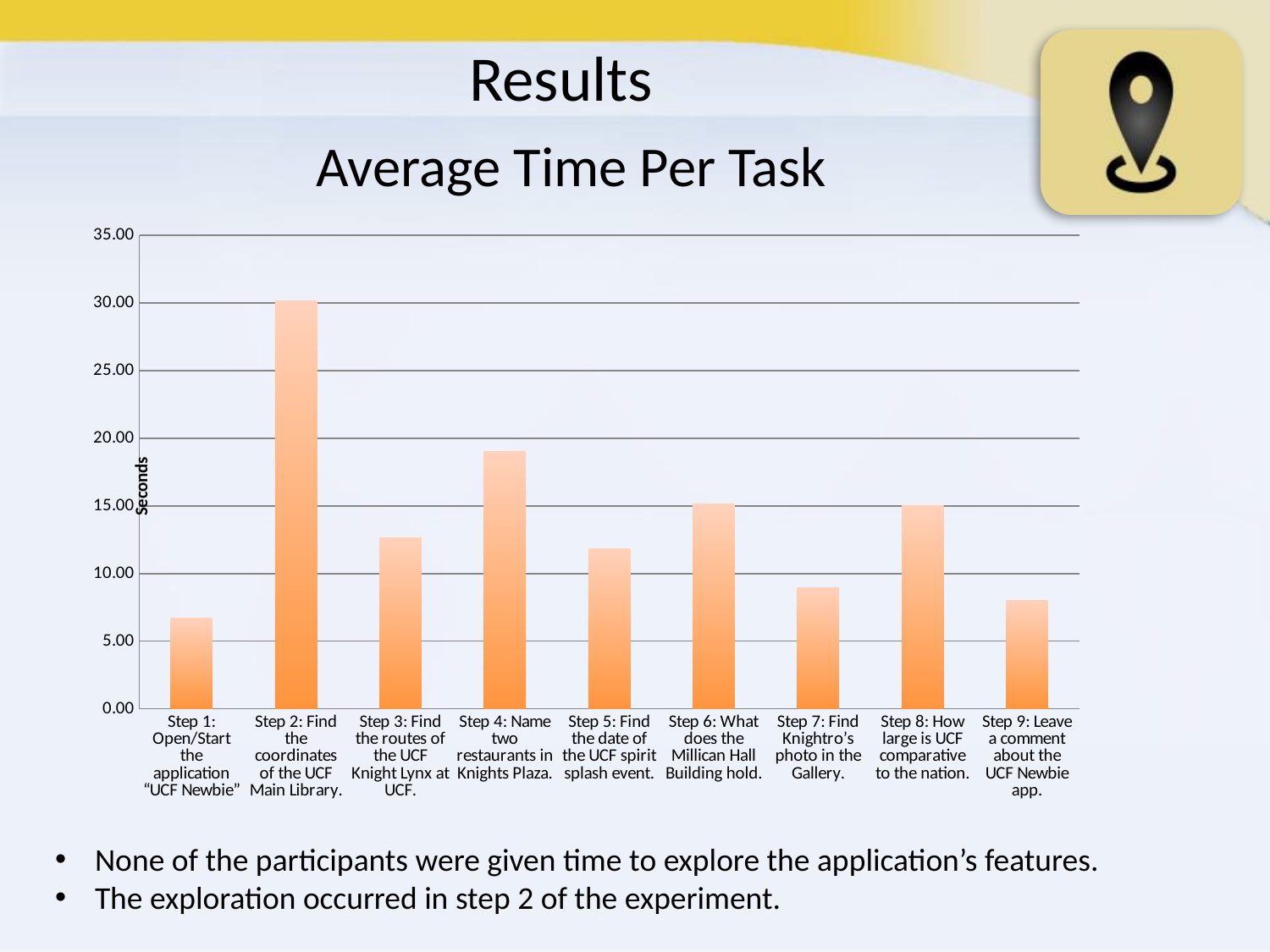
Which step has the lowest average time? Step 1: Open/Start the application "UCF Newbie" How many steps (categories) are plotted in the chart? 9 Is the value for Step 3 greater or less than 10.00? greater Which step has the highest average time? Step 2: Find the coordinates of the UCF Main Library. Is the value for Step 4 greater or less than 20.00? less Which has a larger value, Step 1 or Step 8? Step 8 What kind of chart is shown on the slide? bar chart What is the title of the chart? Average Time Per Task Is the value for Step 2 greater or less than 25.00? greater What is the label on the vertical axis of the chart? Seconds Which has a larger value, Step 4 or Step 5? Step 4